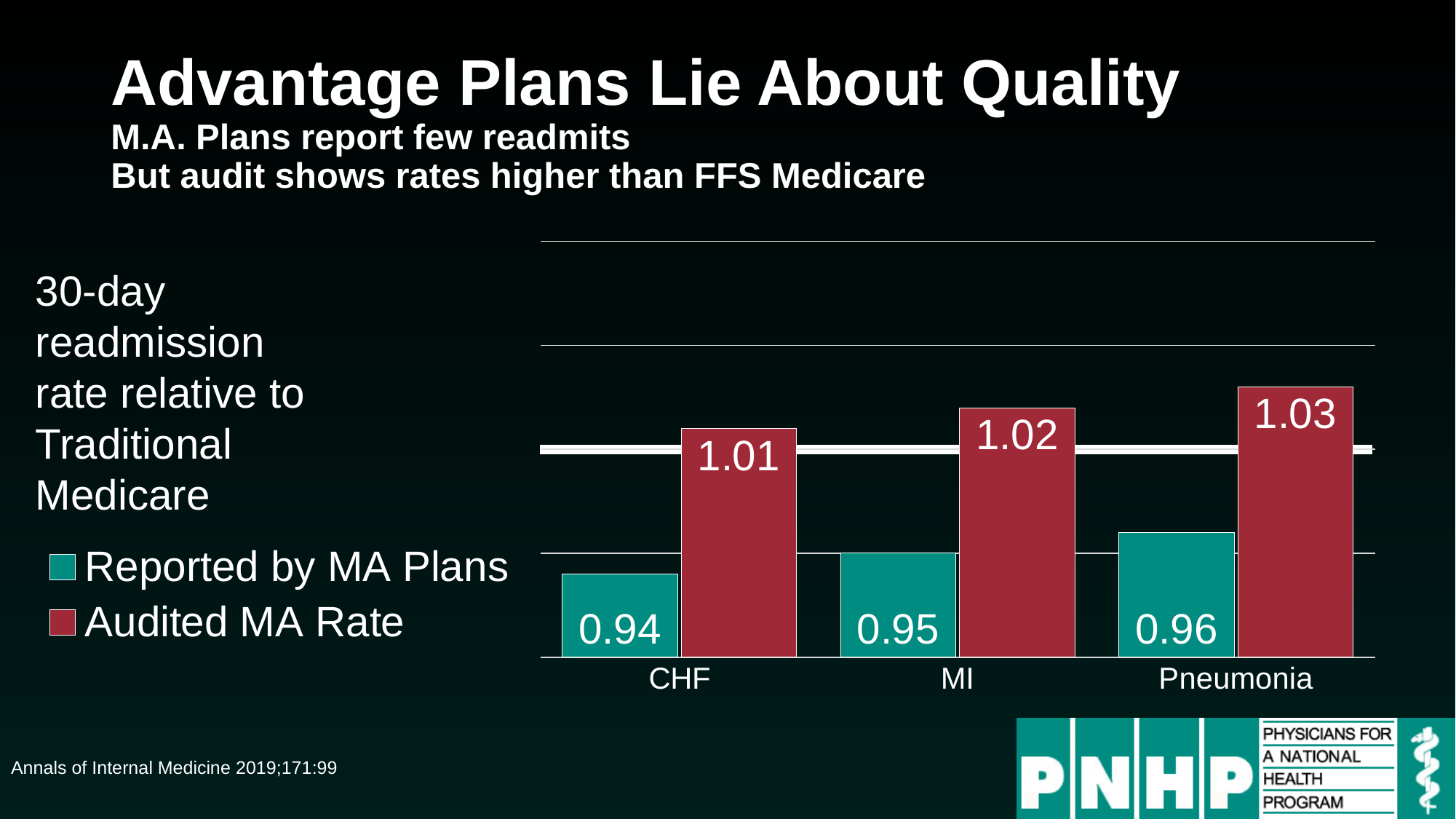
What kind of chart is shown on the slide? Bar chart What is the audited MA rate for MI? 1.02 How many series does the chart's legend list? 2 What is the value reported by MA Plans for Pneumonia? 0.96 What is the audited MA rate for Pneumonia? 1.03 How many categories are shown on the x axis of the chart? 3 Which category has the lowest value reported by MA Plans? CHF Which category has the highest audited MA rate? Pneumonia For Pneumonia, which is larger: the audited MA rate or the rate reported by MA Plans? Audited MA Rate What is the difference between the audited MA rate and the rate reported by MA Plans for MI? 0.07 What is the value reported by MA Plans for CHF? 0.94 What is the difference between the audited MA rate and the rate reported by MA Plans for CHF? 0.07